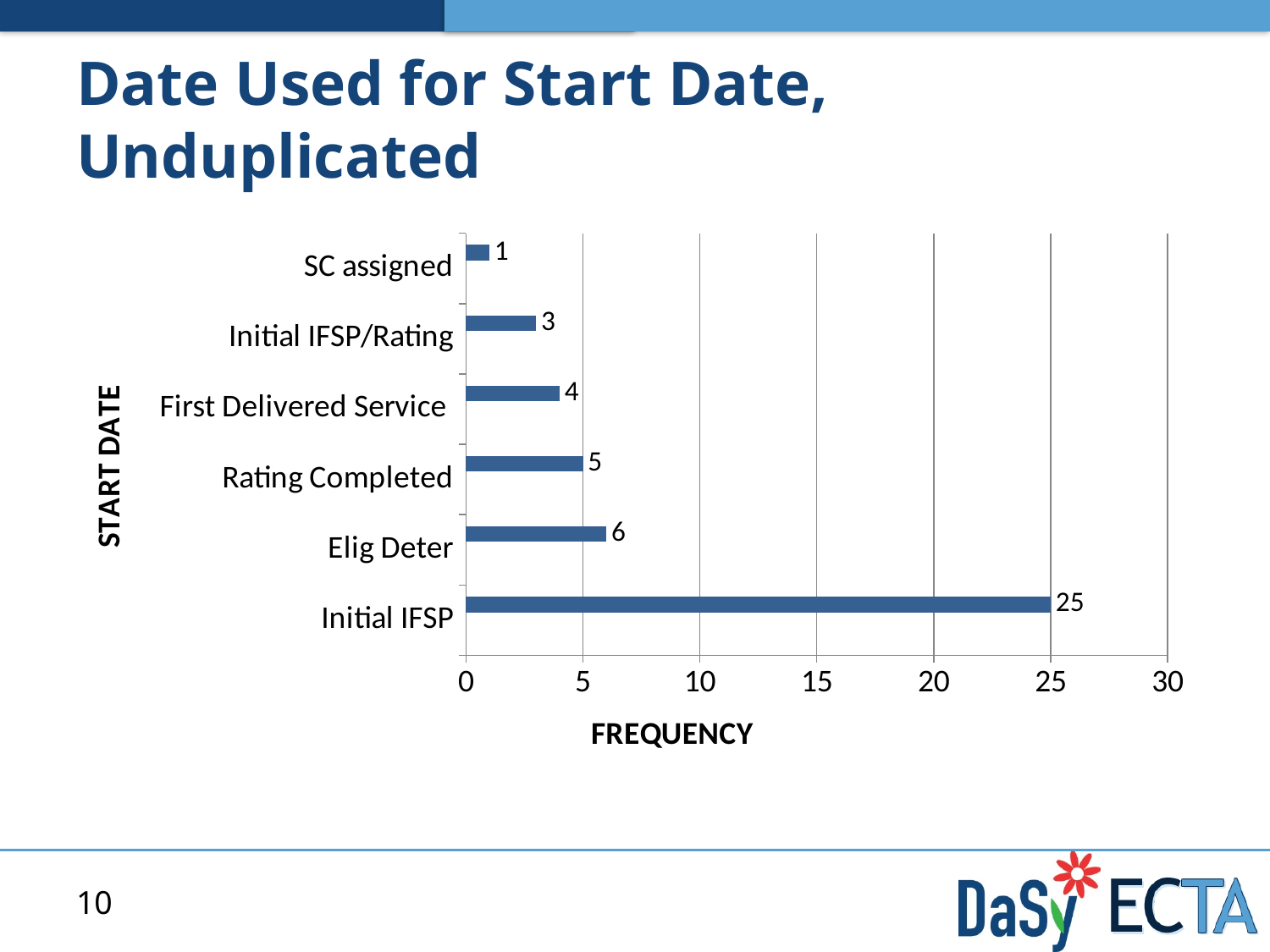
What is the frequency for SC assigned? 1 Which start date category has the lowest frequency? SC assigned What kind of chart is shown on the slide? bar chart Is the frequency for Initial IFSP greater or less than 20? greater What is the label of the horizontal axis of the chart? FREQUENCY Which start date category has the highest frequency? Initial IFSP What is the frequency for Elig Deter? 6 What is the frequency for Initial IFSP? 25 What is the frequency for First Delivered Service? 4 Which has a higher frequency, Rating Completed or Initial IFSP/Rating? Rating Completed What is the difference in frequency between Initial IFSP and Elig Deter? 19 How many start date categories are shown in the chart? 6